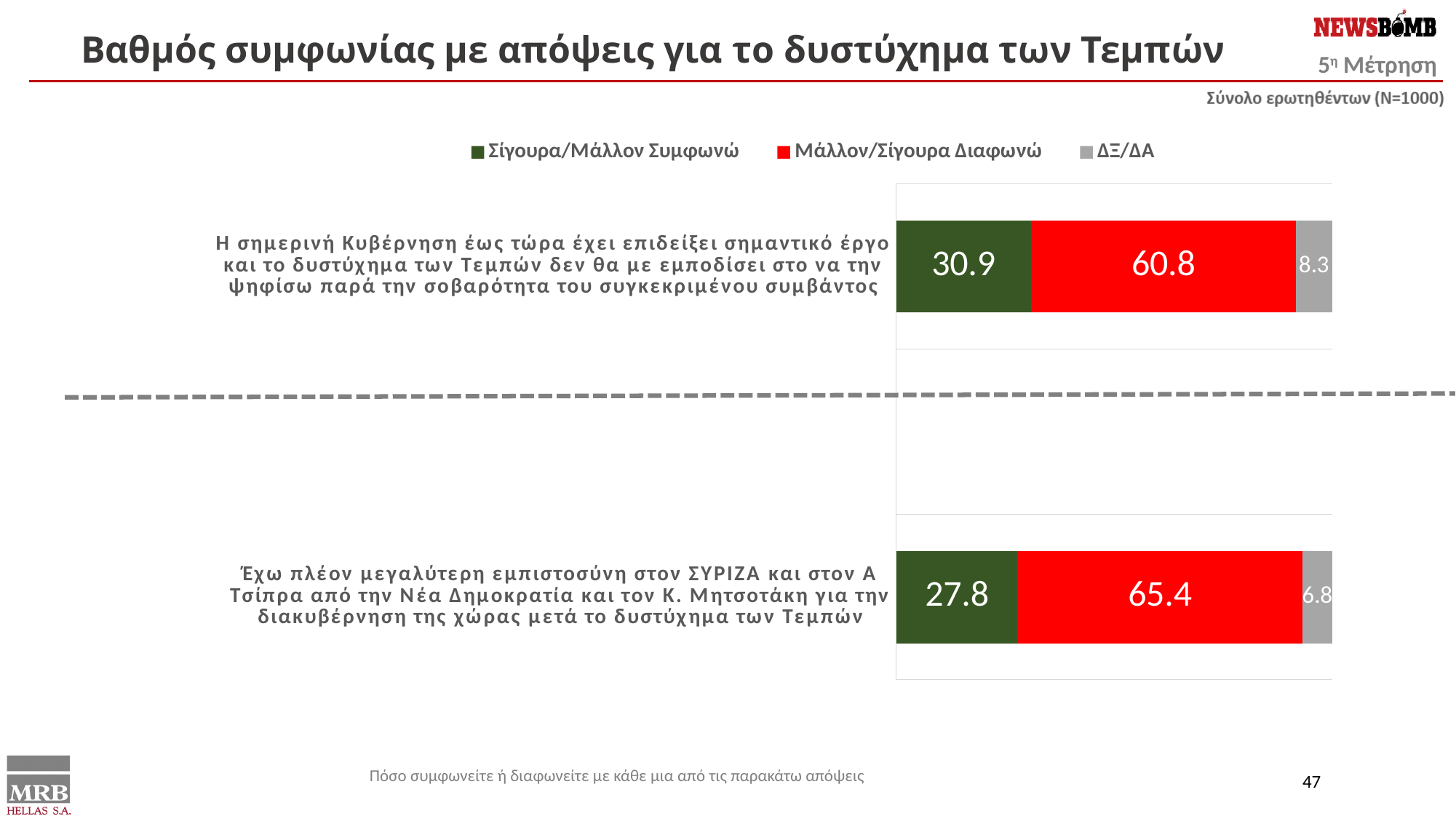
Which of the two statements has the lower Σίγουρα/Μάλλον Συμφωνώ value? Έχω πλέον μεγαλύτερη εμπιστοσύνη στον ΣΥΡΙΖΑ και στον Α. Τσίπρα... What is the total of the stacked bar for the statement about greater trust in ΣΥΡΙΖΑ and Α. Τσίπρα? 100 What type of chart is shown on the slide? Stacked bar chart How many statements (bars) are shown in the chart? 2 What is the ΔΞ/ΔΑ value for the statement about greater trust in ΣΥΡΙΖΑ and Α. Τσίπρα? 6.8 How many series does the legend list? 3 What is the value for Μάλλον/Σίγουρα Διαφωνώ for the statement about having greater trust in ΣΥΡΙΖΑ and Α. Τσίπρα than in Νέα Δημοκρατία and Κ. Μητσοτάκη? 65.4 For the statement about the current government's work, is the Σίγουρα/Μάλλον Συμφωνώ value larger or smaller than the Μάλλον/Σίγουρα Διαφωνώ value? smaller What percentage of respondents agree (Σίγουρα/Μάλλον Συμφωνώ) with the statement that the current government has shown significant work and the Tempi accident will not stop them from voting for it? 30.9 What is the difference between the Μάλλον/Σίγουρα Διαφωνώ values of the two statements? 4.6 What is the ΔΞ/ΔΑ value for the statement about the current government's work and the Tempi accident? 8.3 Which of the two statements has the higher Μάλλον/Σίγουρα Διαφωνώ value? Έχω πλέον μεγαλύτερη εμπιστοσύνη στον ΣΥΡΙΖΑ και στον Α. Τσίπρα...